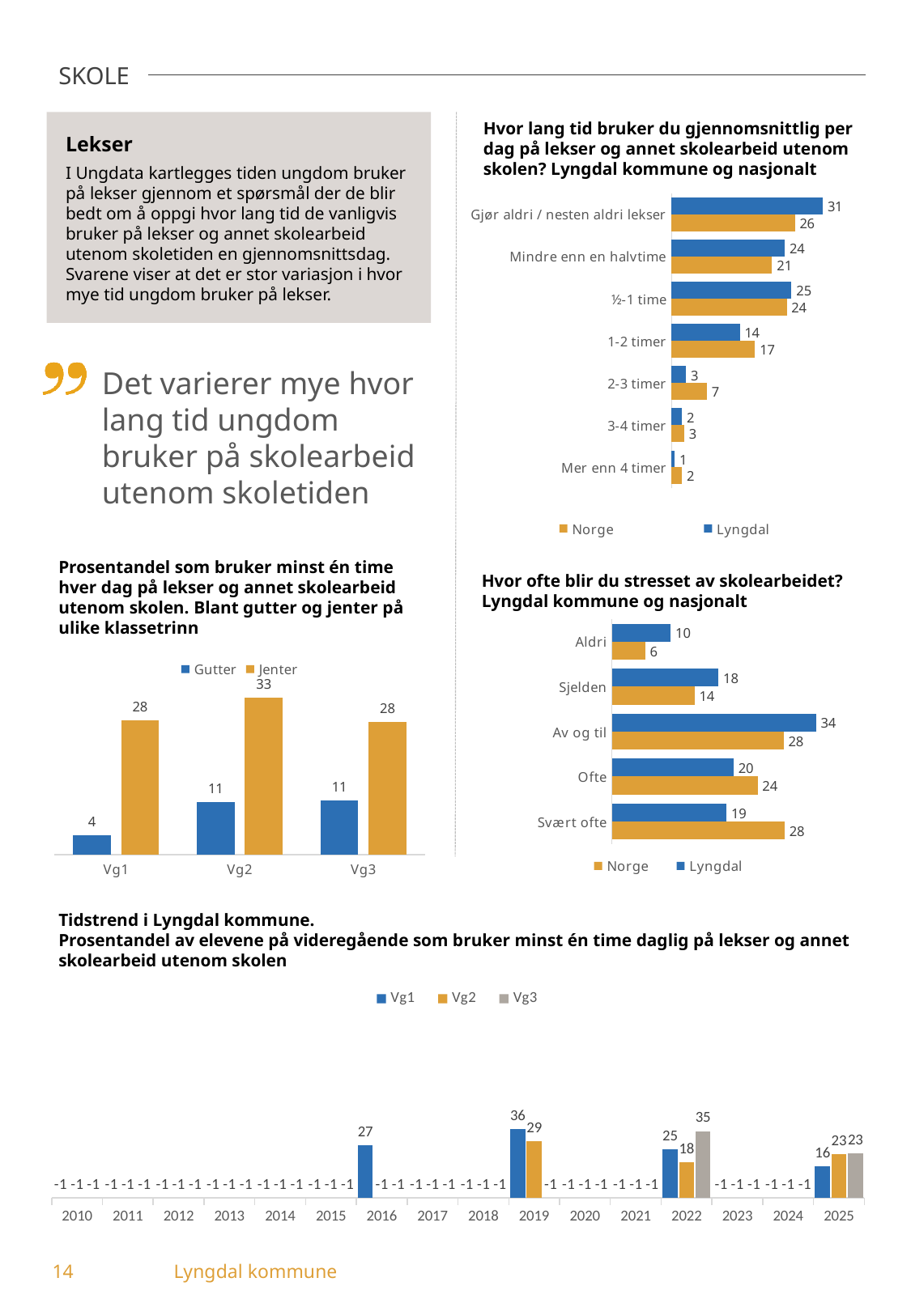
In the chart 'Hvor lang tid bruker du gjennomsnittlig per dag på lekser og annet skolearbeid utenom skolen?', what is the Norge value for '1-2 timer'? 17 In the chart 'Hvor ofte blir du stresset av skolearbeidet?', what is the Norge value for 'Ofte'? 24 In the chart 'Prosentandel som bruker minst én time hver dag på lekser og annet skolearbeid utenom skolen', which class level has the lowest Gutter value? Vg1 In the chart 'Tidstrend i Lyngdal kommune', how many series does the legend list? 3 In the chart 'Hvor lang tid bruker du gjennomsnittlig per dag på lekser og annet skolearbeid utenom skolen?', how many categories are shown? 7 In the chart 'Hvor lang tid bruker du gjennomsnittlig per dag på lekser og annet skolearbeid utenom skolen?', what is the difference between the Norge and Lyngdal values for '2-3 timer'? 4 In the chart 'Hvor ofte blir du stresset av skolearbeidet?', which is larger for 'Svært ofte': Norge or Lyngdal? Norge In the chart 'Hvor ofte blir du stresset av skolearbeidet?', which category has the highest Lyngdal value? Av og til In the chart 'Tidstrend i Lyngdal kommune', what is the Vg3 value for 2022? 35 In the chart 'Prosentandel som bruker minst én time hver dag på lekser og annet skolearbeid utenom skolen', what is the Jenter value for Vg2? 33 In the chart 'Prosentandel som bruker minst én time hver dag på lekser og annet skolearbeid utenom skolen', what is the difference between Jenter and Gutter for Vg1? 24 In the chart 'Hvor lang tid bruker du gjennomsnittlig per dag på lekser og annet skolearbeid utenom skolen?', what is the Lyngdal value for 'Gjør aldri / nesten aldri lekser'? 31